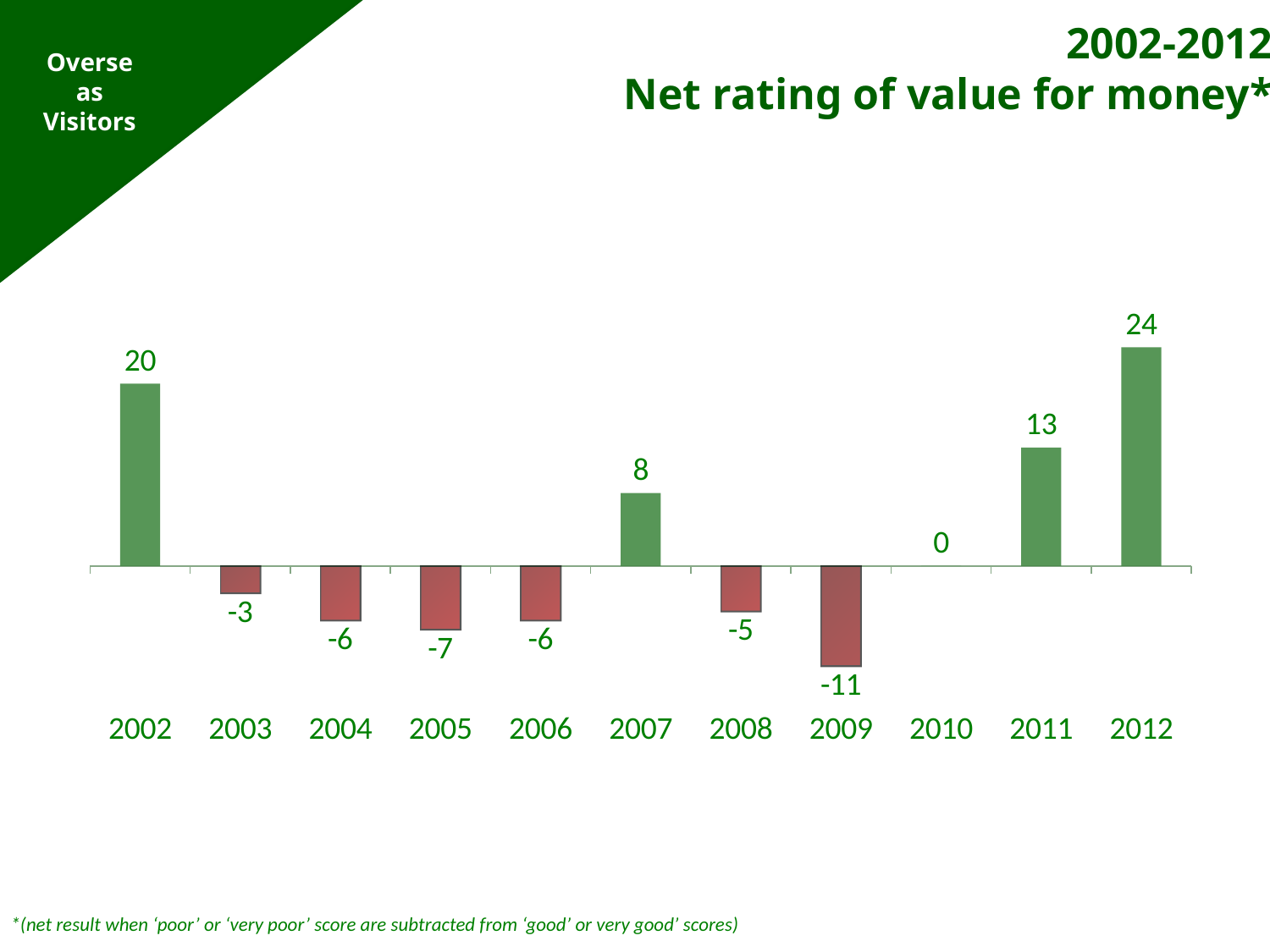
What is the net rating of value for money in 2010? 0 What is the difference between the net rating in 2012 and the net rating in 2011? 11 Which year has the highest net rating of value for money? 2012 What is the net rating of value for money in 2005? -7 What kind of chart is shown on the slide? Bar chart How many years are shown on the chart? 11 What is the net rating of value for money in 2009? -11 What is the net rating of value for money in 2002? 20 Which year has the lowest net rating of value for money? 2009 What colour are the bars with negative values? Red Which year has a higher net rating, 2007 or 2011? 2011 Does the net rating rise or fall from 2010 to 2012? Rise